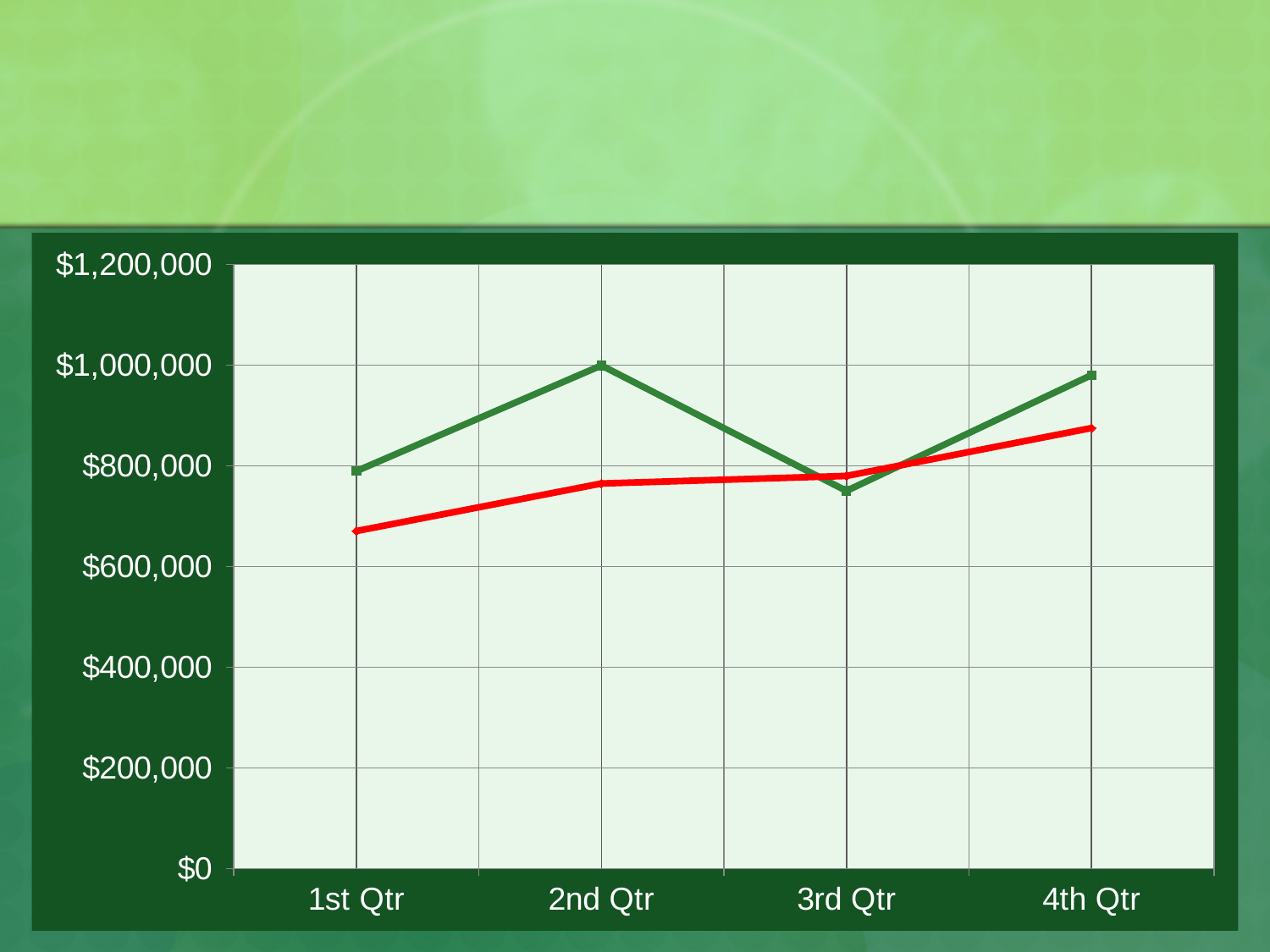
Is the value of the red line in 4th Qtr greater or less than $800,000? greater Is the value of the green line in 4th Qtr greater or less than $800,000? greater What kind of chart is shown on the slide? line chart In which quarter does the red line reach its highest value? 4th Qtr How many lines are plotted on the chart? 2 Is the value of the red line in 1st Qtr greater or less than $800,000? less In 2nd Qtr, which line has the higher value, the green line or the red line? green line Does the red line rise or fall from 1st Qtr to 4th Qtr? rise In which quarter does the red line have its lowest value? 1st Qtr How many quarters are shown on the x axis of the chart? 4